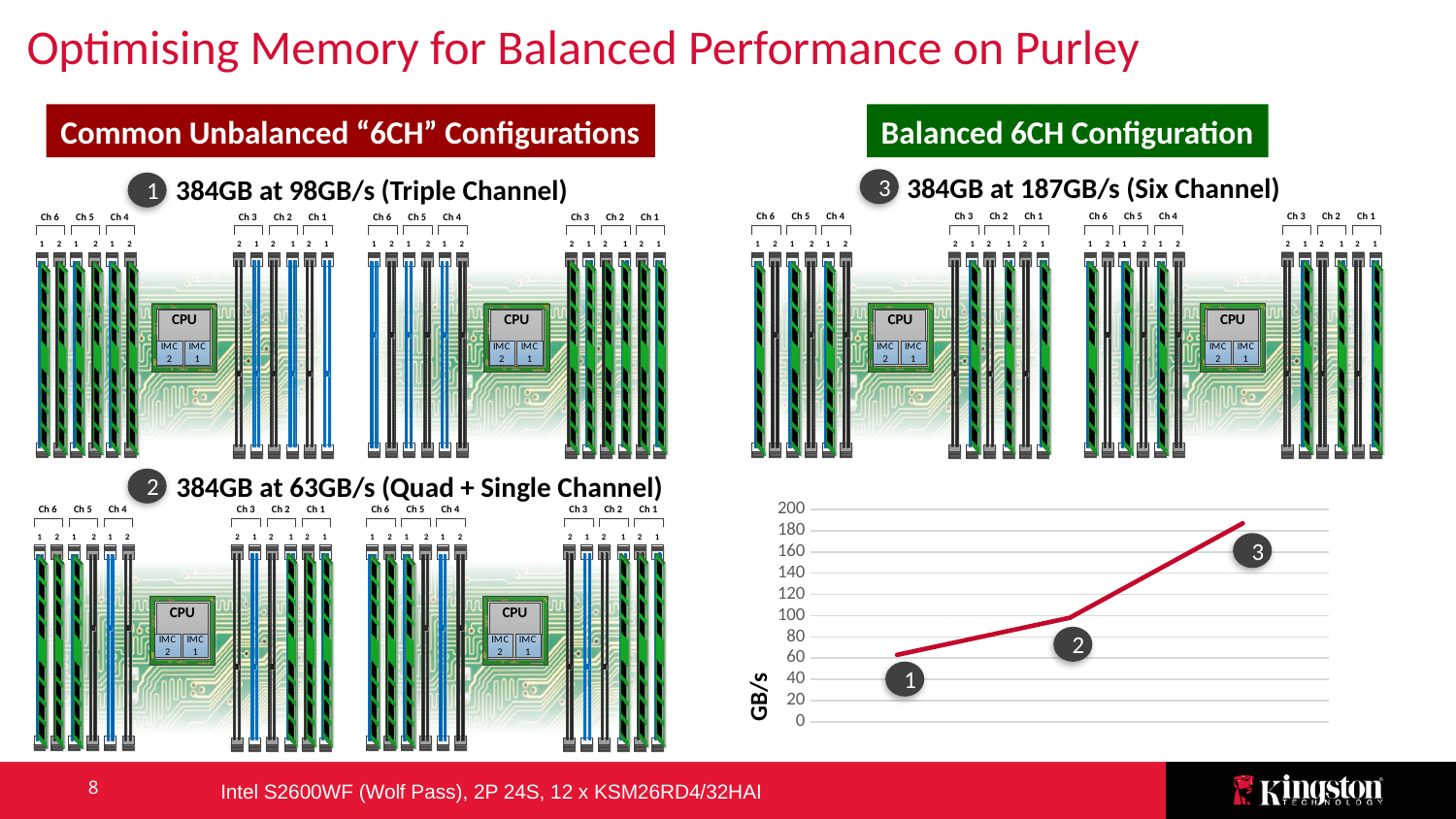
Which numbered point on the line chart has the lowest value? 1 How many numbered data points are marked on the line chart? 3 On the line chart, is the value at point 2 greater or less than 120? less On the line chart, which has the larger value, point 2 or point 3? point 3 On the line chart, is the value at point 3 greater or less than 160? greater What is the highest tick value shown on the vertical axis of the line chart? 200 What is the label on the vertical axis of the line chart? GB/s On the line chart, is the value at point 2 greater or less than 80? greater What kind of chart is shown at the bottom right of the slide? line chart Do the values on the line chart rise or fall from point 1 to point 3? rise Which numbered point on the line chart has the highest value? 3